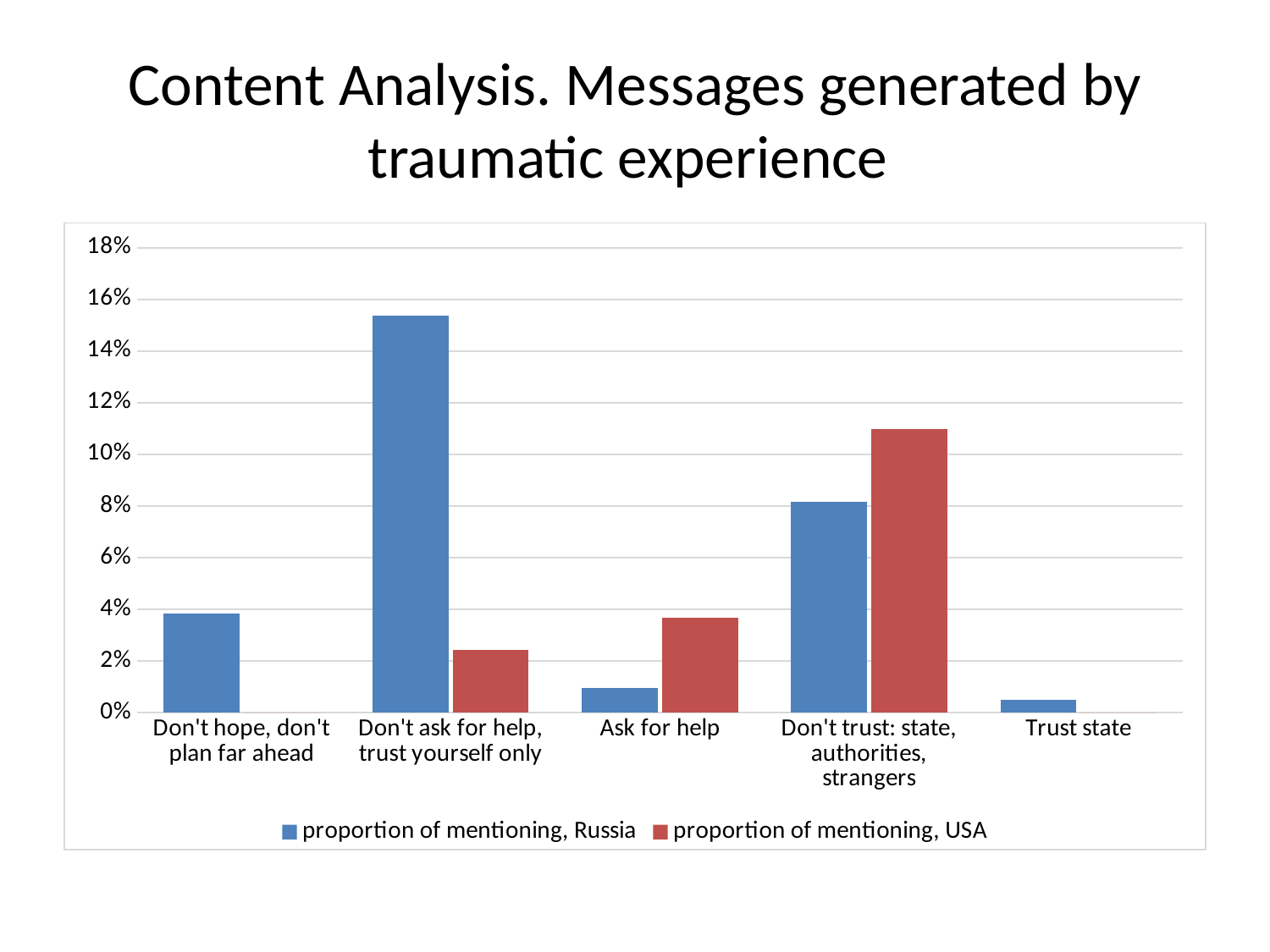
Is the value for 'Ask for help' in the Russia series greater or less than 2%? less How many series does the chart's legend list? 2 How many categories are shown on the x axis of the chart? 5 Which category has the highest value for the series 'proportion of mentioning, USA'? Don't trust: state, authorities, strangers Is the value for 'Don't trust: state, authorities, strangers' in the USA series greater or less than 10%? greater Is the value for 'Ask for help' in the USA series greater or less than 2%? greater For the category 'Don't trust: state, authorities, strangers', which series has the larger value, Russia or USA? USA Which category has the highest value for the series 'proportion of mentioning, Russia'? Don't ask for help, trust yourself only For the category 'Don't ask for help, trust yourself only', which series has the larger value, Russia or USA? Russia What kind of chart is shown on the slide? bar chart What colour are the bars for the series 'proportion of mentioning, USA'? red